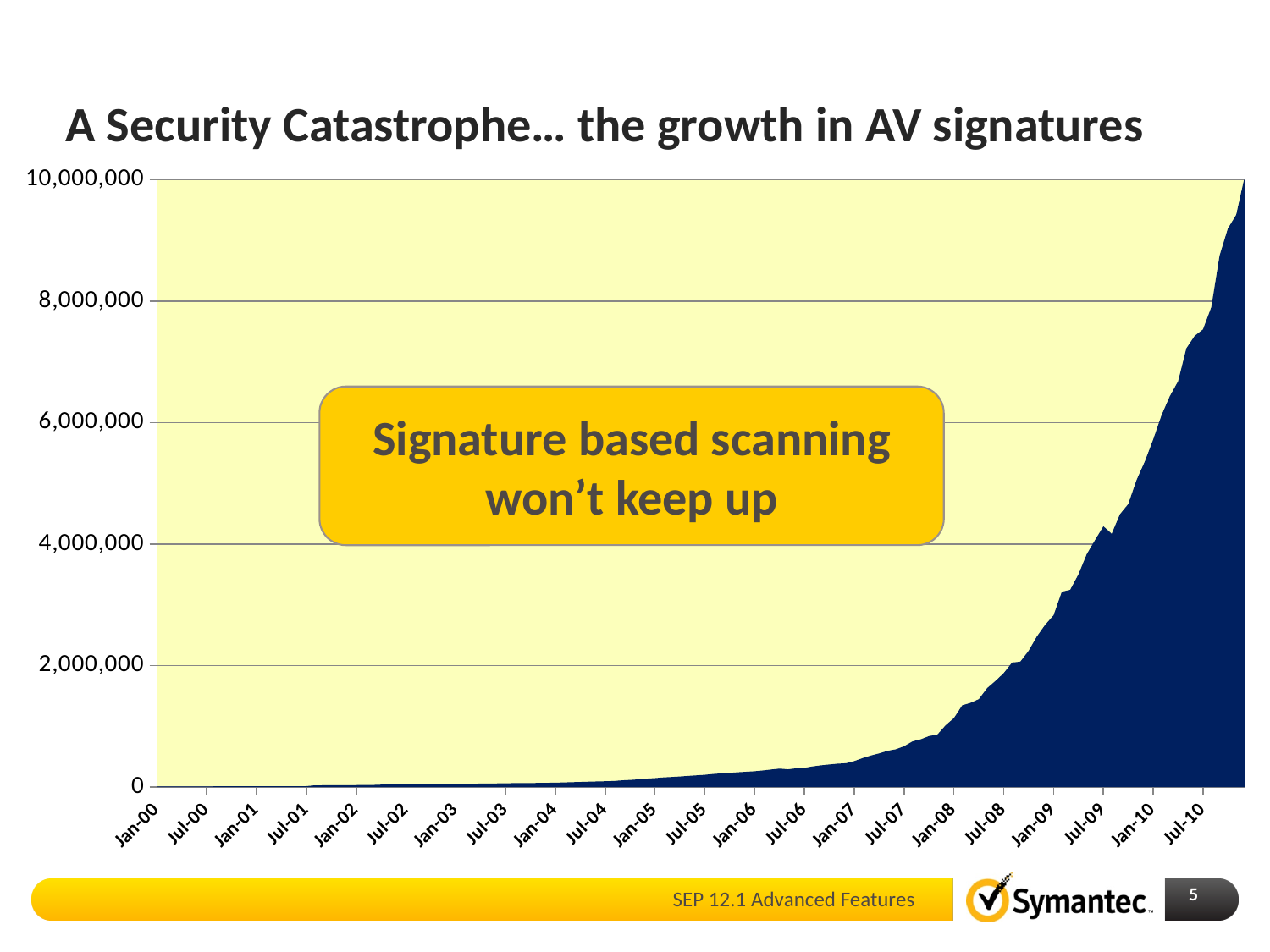
How many date labels are shown along the x axis of the chart? 22 What is the highest value shown on the vertical axis of the chart? 10,000,000 Is the value for Jan-05 greater or less than 2,000,000? less Is the value for Jan-10 greater or less than 4,000,000? greater Do the values in the chart generally rise or fall from Jan-00 to Jul-10? Rise What is the title of the slide containing the chart? A Security Catastrophe… the growth in AV signatures What kind of chart is shown on the slide? Area chart Is the value for Jan-08 greater or less than 2,000,000? less Which is larger, the value for Jan-10 or the value for Jan-08? Jan-10 At which end of the x axis does the chart reach its lowest values, Jan-00 or Jul-10? Jan-00